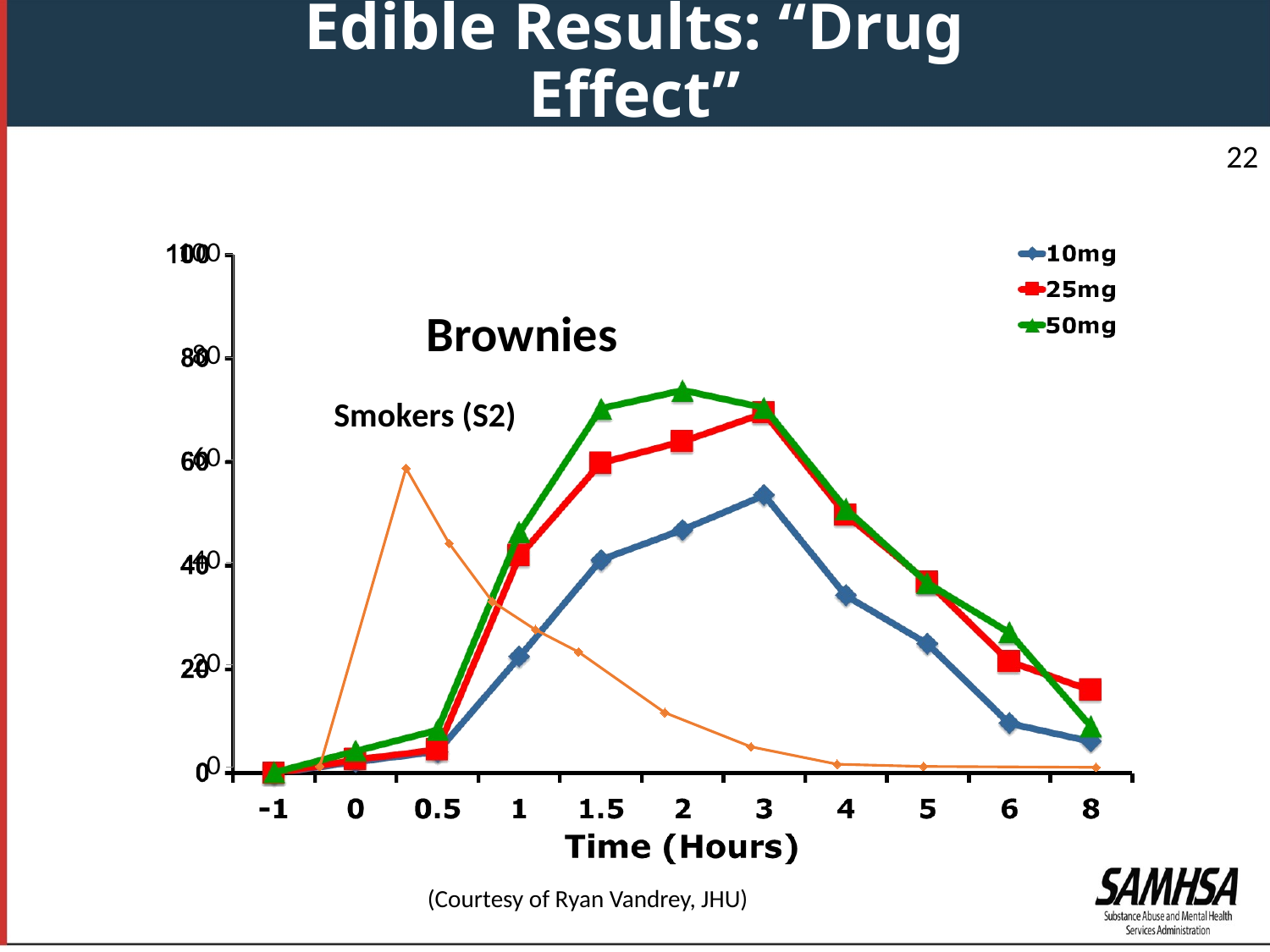
What kind of chart is shown on the slide? line chart At 3 hours, which is larger: the 10mg value or the 50mg value? 50mg At which time does the 50mg series reach its highest value? 2 At which time does the 10mg series reach its highest value? 3 How many series does the legend list? 3 What is the title of the x axis? Time (Hours) Is the value for 50mg at 2 hours greater or less than 60? greater How many time points are labelled on the x axis? 11 Is the value for 10mg at 8 hours greater or less than 20? less Does the 10mg series rise or fall between 3 hours and 8 hours? fall Which series reaches the highest peak value? 50mg Which colour is used for the 50mg series? green